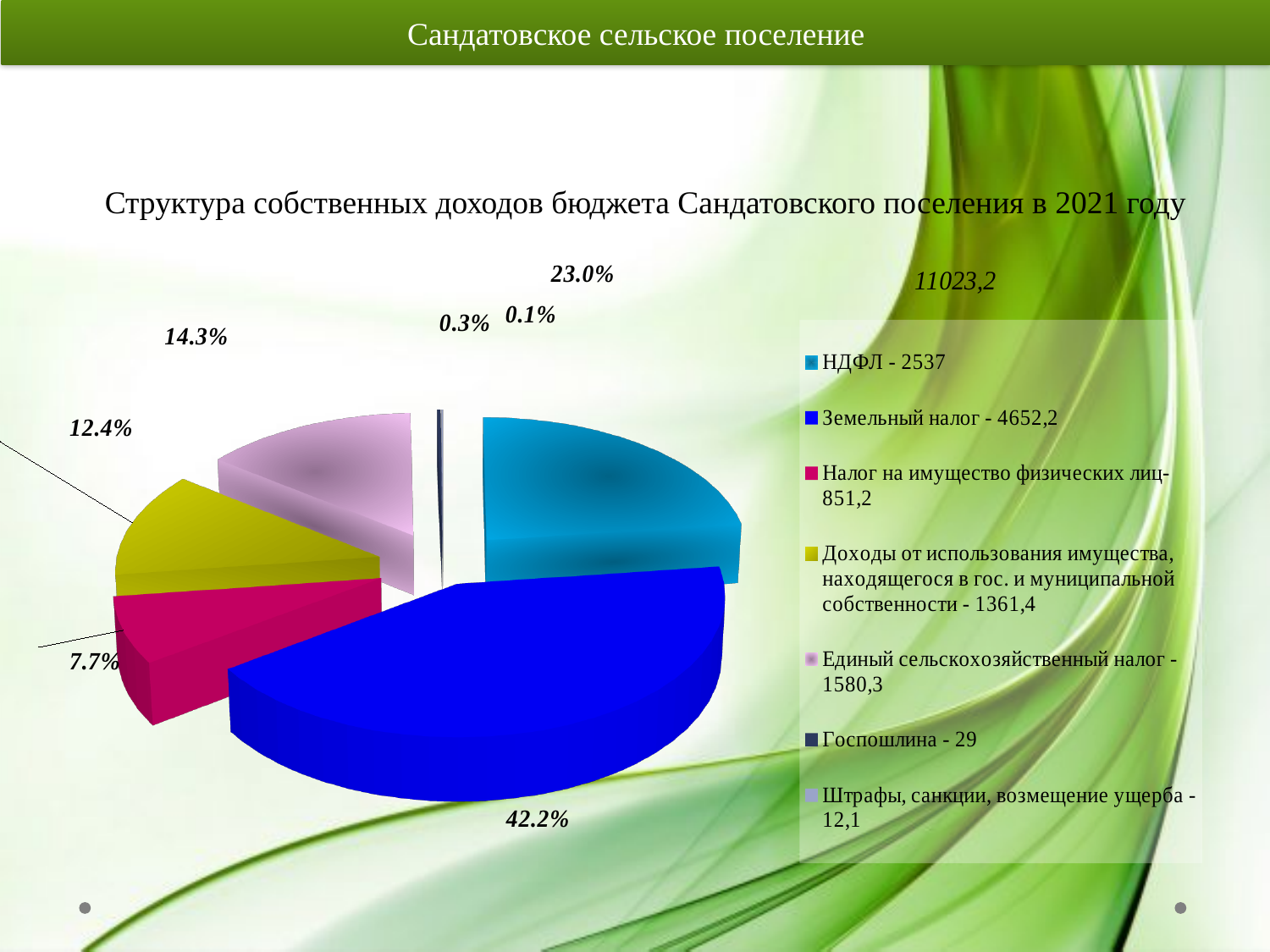
Which category has the smallest slice of the pie? Штрафы, санкции, возмещение ущерба Which category has the largest slice of the pie? Земельный налог What share of the pie does Земельный налог take? 42.2% How many entries does the legend list? 7 What kind of chart is shown on the slide? pie chart Which is larger: the value for НДФЛ or the value for Единый сельскохозяйственный налог? НДФЛ What share of the pie does Единый сельскохозяйственный налог take? 14.3% What value is given in the legend for Налог на имущество физических лиц? 851,2 What value is given in the legend for Госпошлина? 29 How many slices does the pie chart have? 7 What share of the pie does НДФЛ take? 23.0%